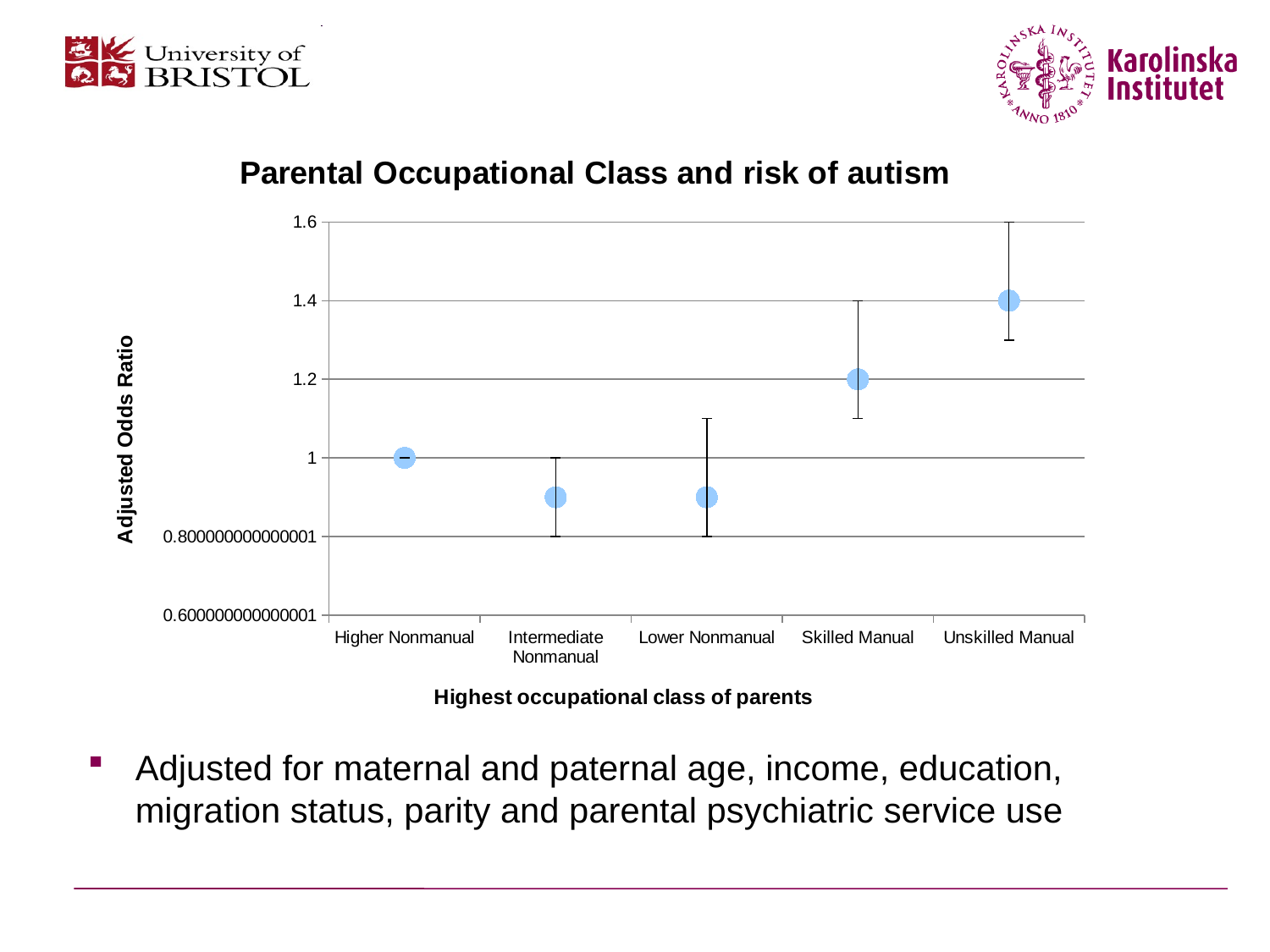
Is the adjusted odds ratio for Lower Nonmanual greater or less than 1? less What is the adjusted odds ratio for Higher Nonmanual? 1 Which occupational class has the highest adjusted odds ratio? Unskilled Manual Which has a larger adjusted odds ratio, Skilled Manual or Intermediate Nonmanual? Skilled Manual What is the adjusted odds ratio for Unskilled Manual? 1.4 What is the difference between the adjusted odds ratios for Unskilled Manual and Skilled Manual? 0.2 What is the difference between the adjusted odds ratios for Unskilled Manual and Higher Nonmanual? 0.4 Is the adjusted odds ratio for Intermediate Nonmanual greater or less than 1? less What kind of chart is shown on the slide? Scatter (dot) plot with error bars How many occupational class categories are plotted on the x axis? 5 What is the adjusted odds ratio for Skilled Manual? 1.2 What is the title of the chart? Parental Occupational Class and risk of autism